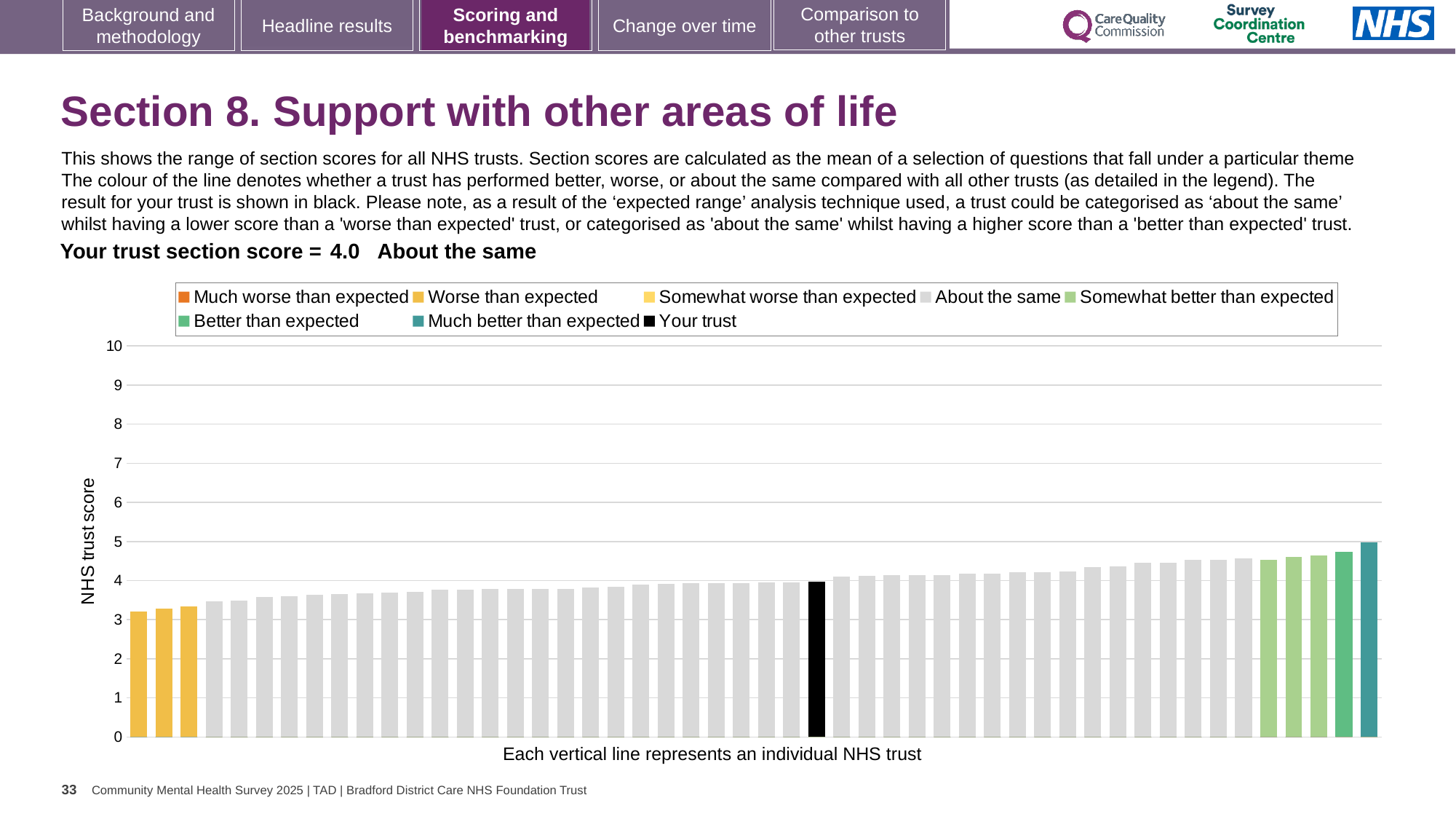
Which category does your trust's section score fall into? About the same Is the value for your trust (black bar) greater or less than 5? less Which legend category does the highest bar belong to? Much better than expected Is the value of the shortest bar greater or less than 3.5? less How many entries does the chart legend list? 8 What kind of chart is shown on the slide? bar chart What is the section score for your trust shown on the slide? 4.0 Do the bar values rise or fall from left to right along the x axis? rise What is the label on the y axis of the chart? NHS trust score How many bars are coloured as 'Worse than expected'? 3 Which legend category do the lowest bars belong to? Worse than expected Is the value of the tallest bar (Much better than expected) greater or less than 4? greater